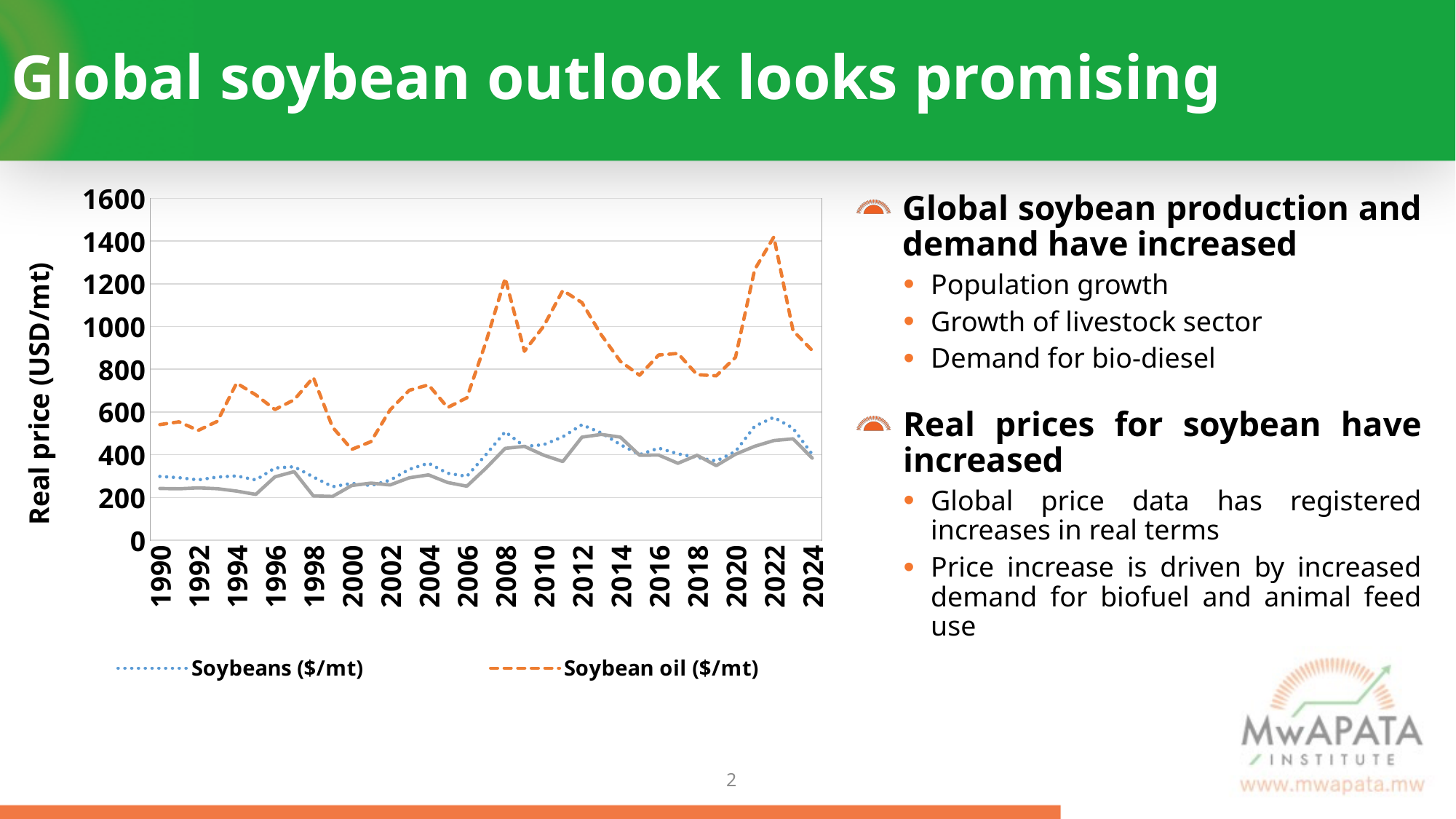
In 2008, which series has the larger value, Soybeans ($/mt) or Soybean oil ($/mt)? Soybean oil ($/mt) How many series does the chart legend list? 2 What kind of chart is shown on the slide? Line chart In which year is the Soybean oil ($/mt) series at its lowest value? 2000 What is the title of the vertical axis of the chart? Real price (USD/mt) Is the value for Soybean oil ($/mt) in 1990 greater or less than 600? less Is the value for Soybean oil ($/mt) in 2022 greater or less than 1200? greater Is the value for Soybeans ($/mt) in 1990 greater or less than 400? less Does the Soybean oil ($/mt) series rise or fall between 2022 and 2024? Fall In which year does the Soybean oil ($/mt) series reach its highest value? 2022 Which series is drawn with an orange dashed line? Soybean oil ($/mt)